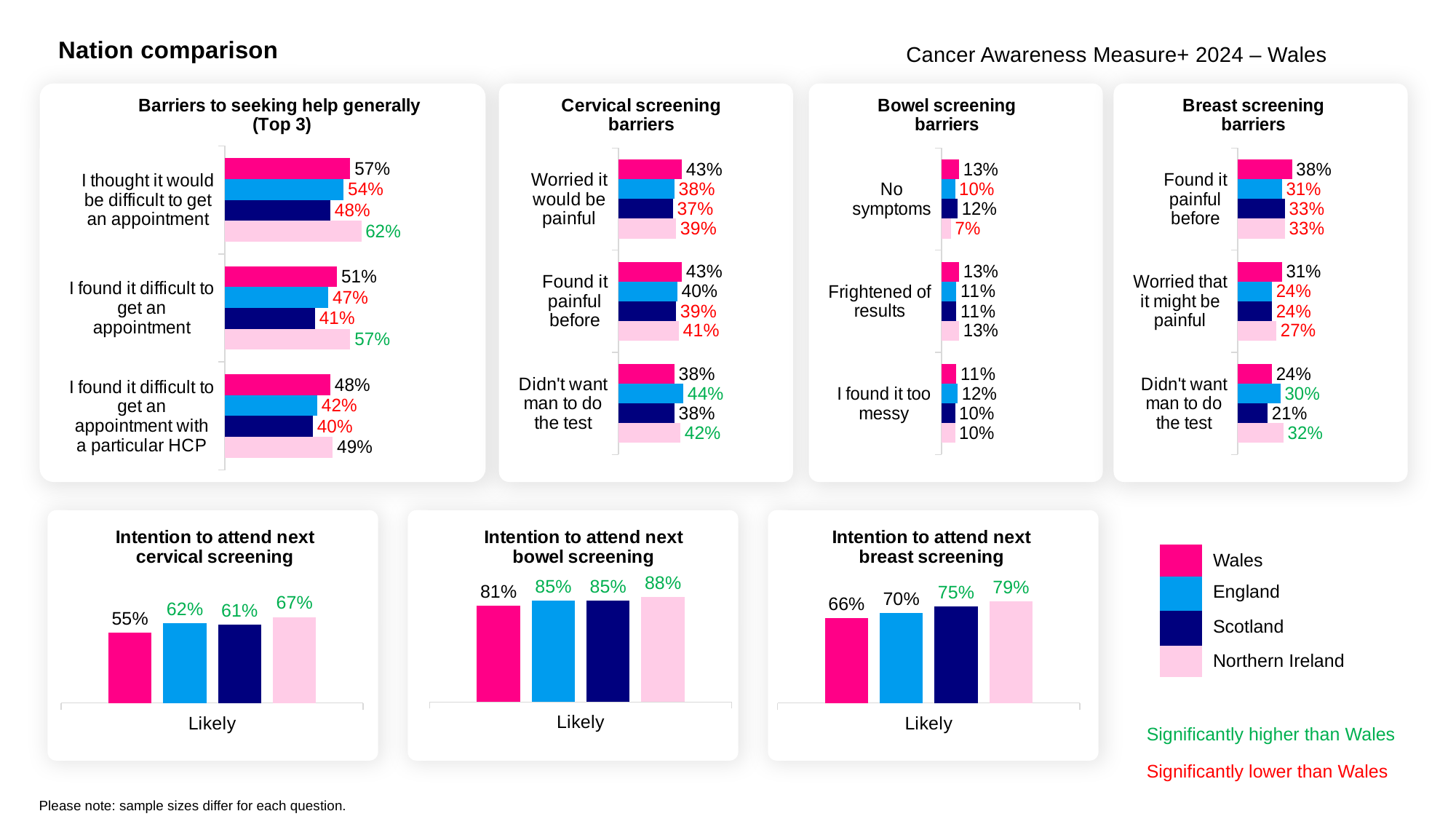
In the 'Breast screening barriers' chart, which nation has the highest value for 'Found it painful before'? Wales In the 'Cervical screening barriers' chart, what is the difference between the Wales value and the Scotland value for 'Worried it would be painful'? 6% How many categories are shown in the 'Barriers to seeking help generally (Top 3)' chart? 3 How many series does the legend list? 4 In the 'Cervical screening barriers' chart, what is the value for England for 'Didn't want man to do the test'? 44% In the 'Intention to attend next breast screening' chart, which is larger: the value for Scotland or the value for England? Scotland In the 'Barriers to seeking help generally (Top 3)' chart, what is the value for Northern Ireland for 'I thought it would be difficult to get an appointment'? 62% What kind of chart is the 'Intention to attend next cervical screening' chart? Bar chart In the 'Intention to attend next cervical screening' chart, which nation has the lowest value? Wales In the 'Intention to attend next bowel screening' chart, what is the difference between the Northern Ireland value and the Wales value? 7% In the 'Bowel screening barriers' chart, what is the value for Northern Ireland for 'No symptoms'? 7% Which colour represents Scotland in the legend? Dark navy blue